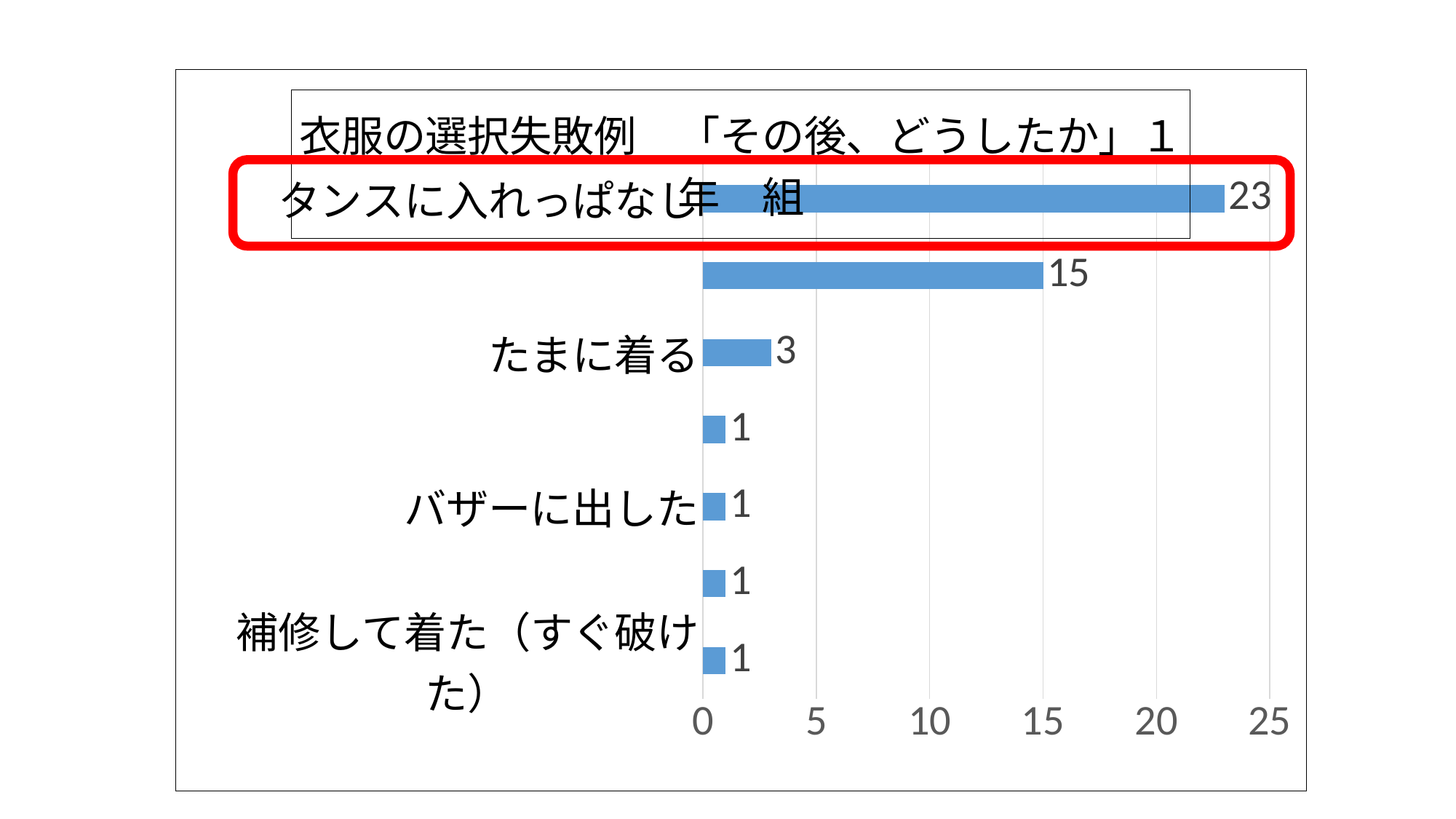
What kind of chart is shown on the slide? Bar chart What is the maximum value shown on the horizontal axis? 25 What is the difference between the highest bar (23) and the second highest bar (15)? 8 What is the value for バザーに出した? 1 How many bars are plotted in the chart? 7 Which category has the highest value? タンスに入れっぱなし What is the value for タンスに入れっぱなし? 23 Is the value for タンスに入れっぱなし greater or less than 20? greater What is the value for 補修して着た（すぐ破けた）? 1 What is the value for たまに着る? 3 Which is larger, the value for たまに着る or the value for バザーに出した? たまに着る What is the difference between the values for タンスに入れっぱなし and たまに着る? 20